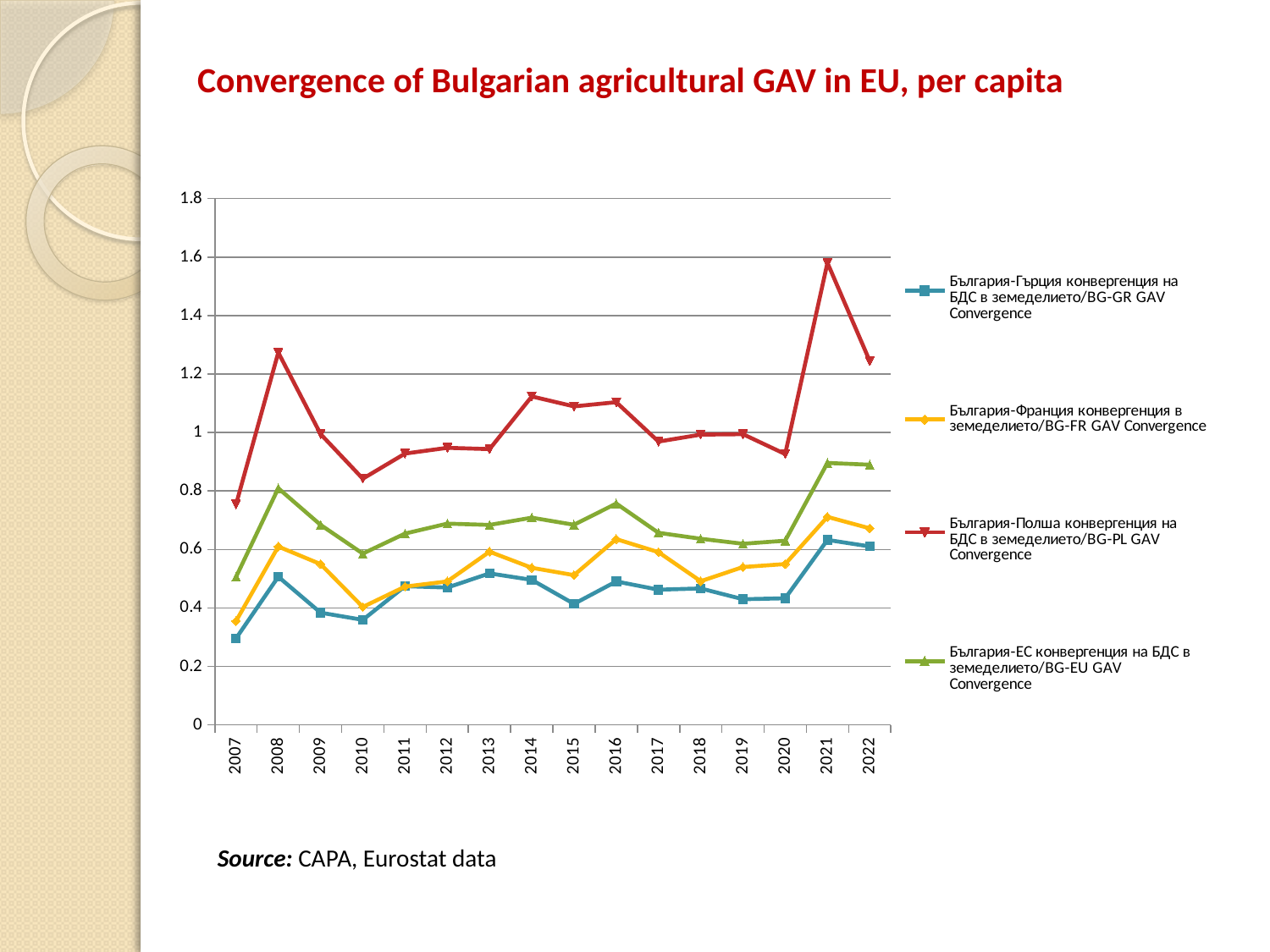
In which year does the BG-PL GAV Convergence series reach its highest value? 2021 Does the BG-PL GAV Convergence series rise or fall from 2020 to 2021? rise Is the value for BG-FR GAV Convergence in 2010 greater or less than 0.6? less What kind of chart is shown on the slide? line chart How many series does the legend list? 4 Is the value for BG-PL GAV Convergence in 2021 greater or less than 1.4? greater In which year is the BG-GR GAV Convergence series at its lowest? 2007 Is the value for BG-GR GAV Convergence in 2007 greater or less than 0.4? less How many years are plotted along the x axis? 16 Which is larger in 2016: BG-EU GAV Convergence or BG-FR GAV Convergence? BG-EU GAV Convergence What is the title of the chart? Convergence of Bulgarian agricultural GAV in EU, per capita Which series has the highest value in 2021? BG-PL GAV Convergence